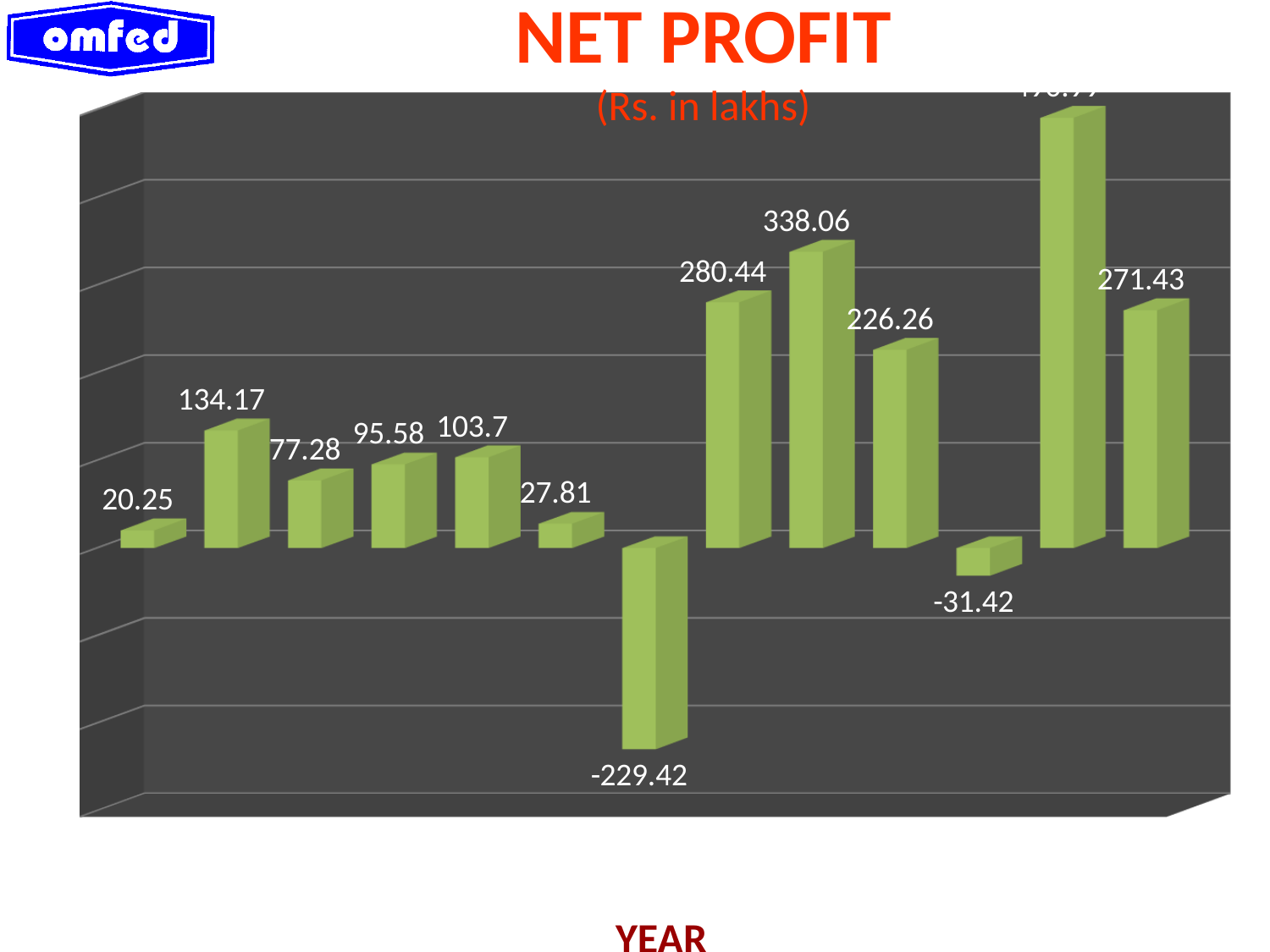
In what units are the values on the chart expressed? Rs. in lakhs What is the lowest value plotted on the chart? -229.42 What is the value shown on the first (leftmost) bar? 20.25 What kind of chart is shown on the slide? bar chart What is the value shown on the last (rightmost) bar? 271.43 What is the value shown on the second bar from the left? 134.17 What is the title of the chart? NET PROFIT What is the value of the bar labelled 338.06's left-hand neighbour? 280.44 How many bars on the chart have negative values? 2 Which is larger, the bar labelled 280.44 or the bar labelled 226.26? 280.44 What is the difference between the bars labelled 338.06 and 280.44? 57.62 How many bars are plotted on the chart? 13